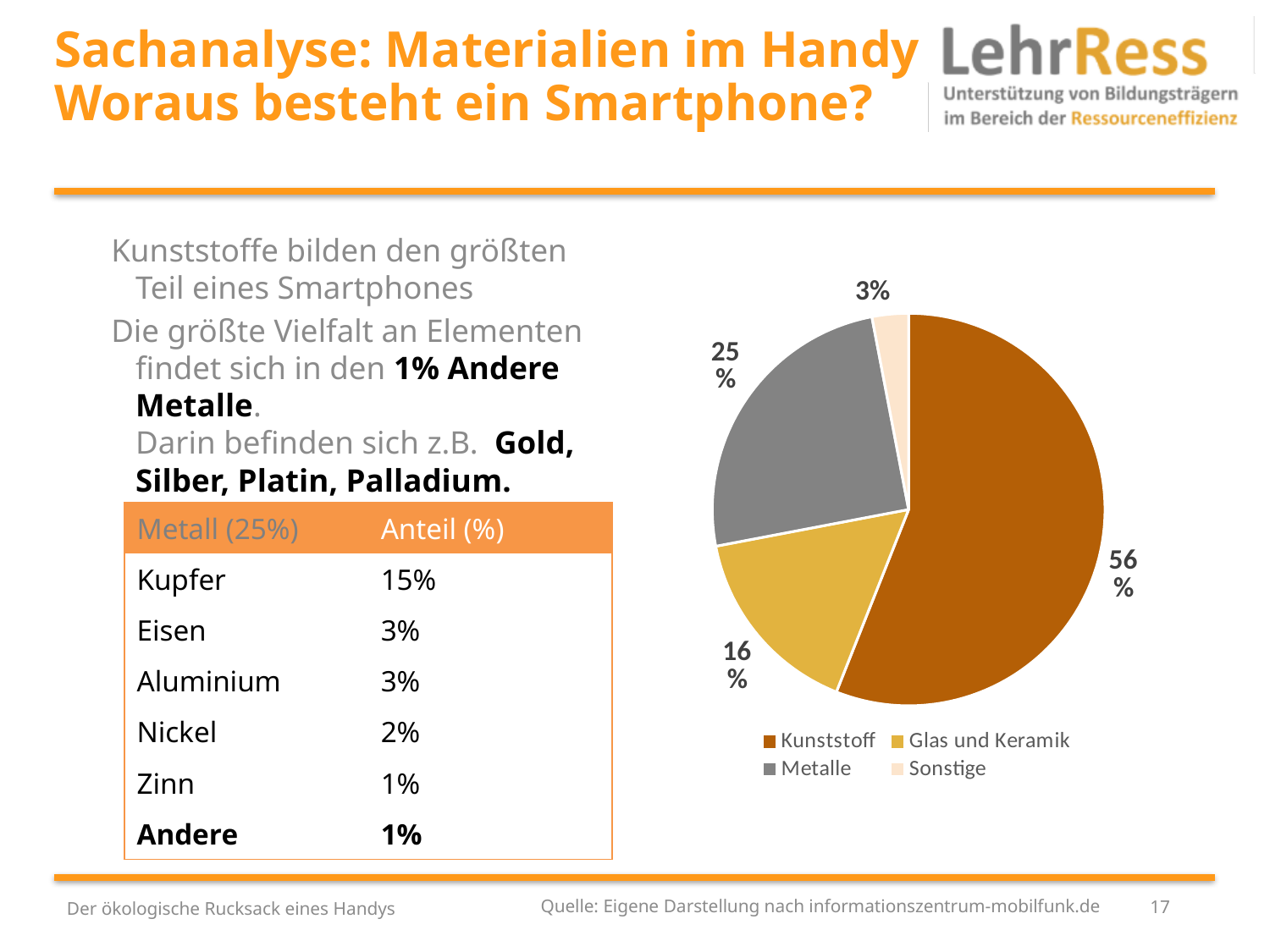
Which category has the smallest slice in the pie chart? Sonstige Which slice is larger in the pie chart, Metalle or Glas und Keramik? Metalle What share of the pie chart does Glas und Keramik have? 16% Which legend entry of the pie chart is shown in grey? Metalle What share of the pie chart does Kunststoff have? 56% How many entries does the legend of the pie chart list? 4 What share of the pie chart does Sonstige have? 3% What is the difference in percentage points between Kunststoff and Metalle in the pie chart? 31 Which category has the largest slice in the pie chart? Kunststoff What kind of chart is shown on the slide? pie chart What share of the pie chart does Metalle have? 25% How many slices does the pie chart have? 4